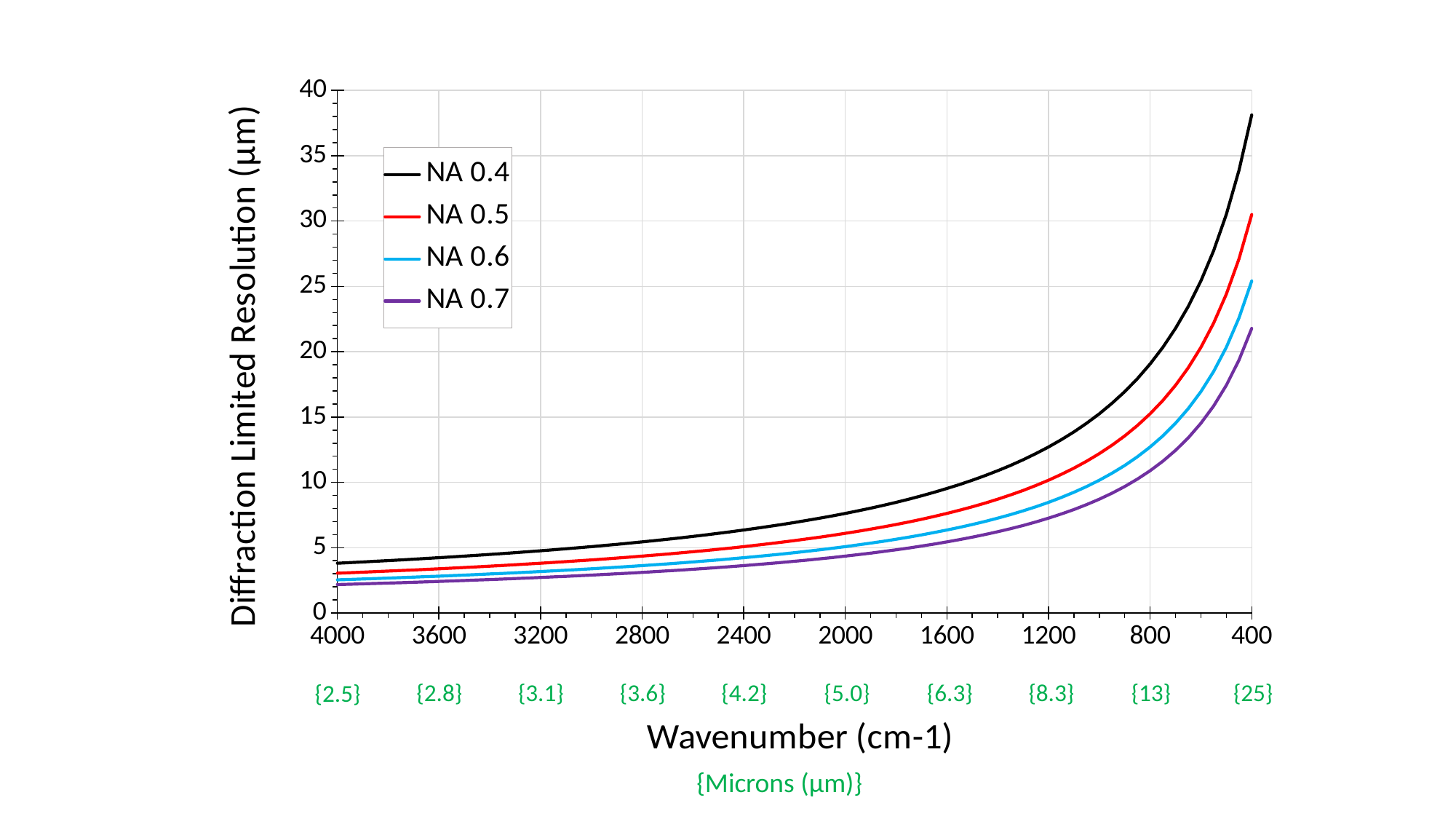
At 400 cm-1, which is larger: the value for NA 0.4 or the value for NA 0.7? NA 0.4 What kind of chart is shown on the slide? line chart Is the value for NA 0.4 at 4000 cm-1 greater or less than 5? less Is the value for NA 0.4 at 400 cm-1 greater or less than 35? greater Which series has the lowest diffraction limited resolution at 400 cm-1? NA 0.7 Which series has the highest diffraction limited resolution at 400 cm-1? NA 0.4 Is the value for NA 0.7 at 400 cm-1 greater or less than 20? greater Do the values of the NA 0.4 series rise or fall moving from left to right along the x axis (from 4000 to 400 cm-1)? rise What colour is the line for the NA 0.5 series? red How many series does the legend list? 4 What is the title of the y axis? Diffraction Limited Resolution (µm)